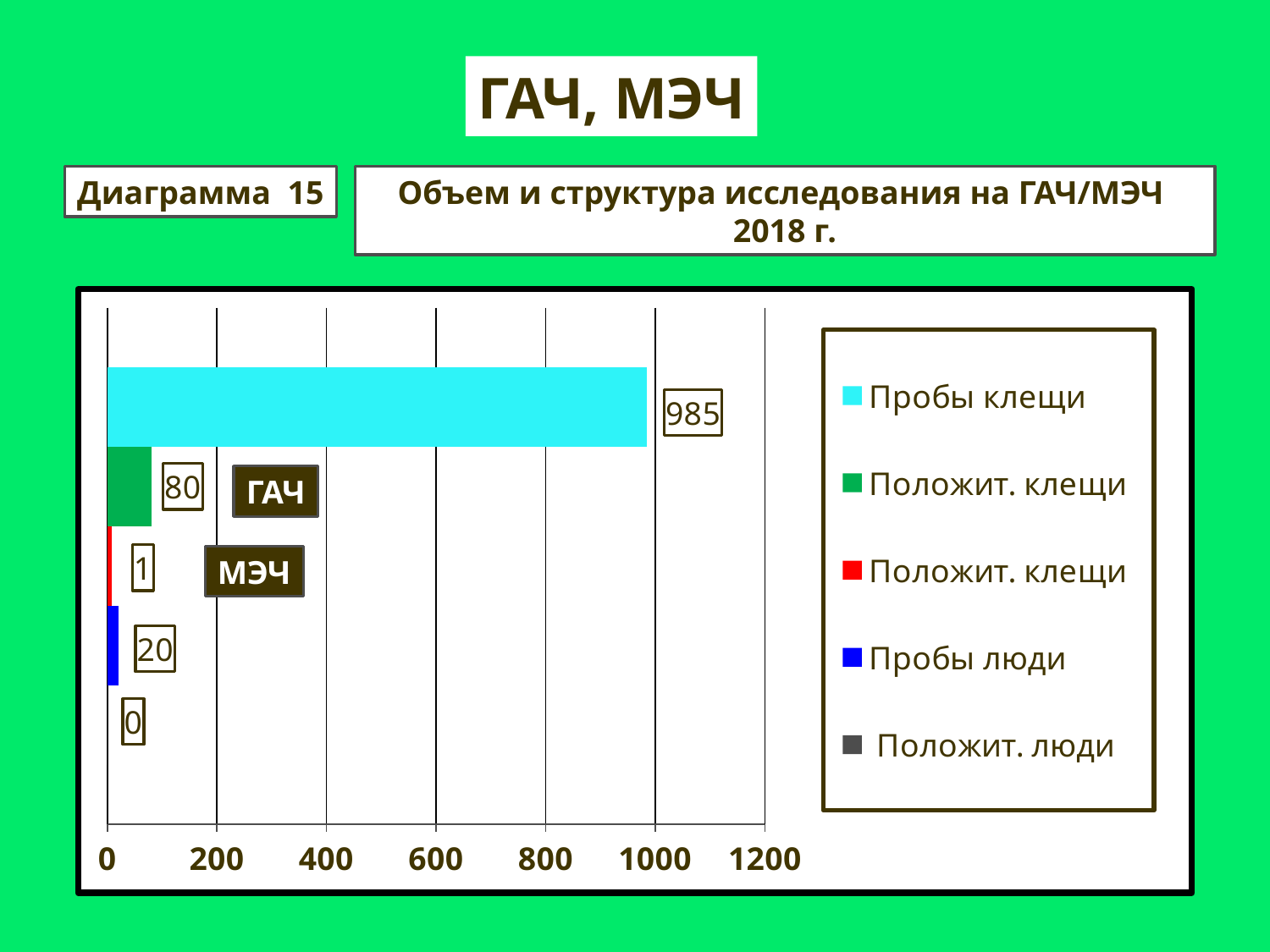
Which series has the highest value? Пробы клещи What is the difference between Пробы клещи and Пробы люди? 965 What is the value for Положит. люди? 0 What is the value of the red bar (Положит. клещи, МЭЧ)? 1 Is the value for Пробы клещи greater or less than 800? greater What is the value for Пробы клещи? 985 What is the value of the green bar (Положит. клещи, ГАЧ)? 80 How many series does the legend list? 5 Which is larger: the green Положит. клещи bar or Пробы люди? Положит. клещи (green) Which series has the lowest value? Положит. люди What kind of chart is shown? bar chart What is the value for Пробы люди? 20